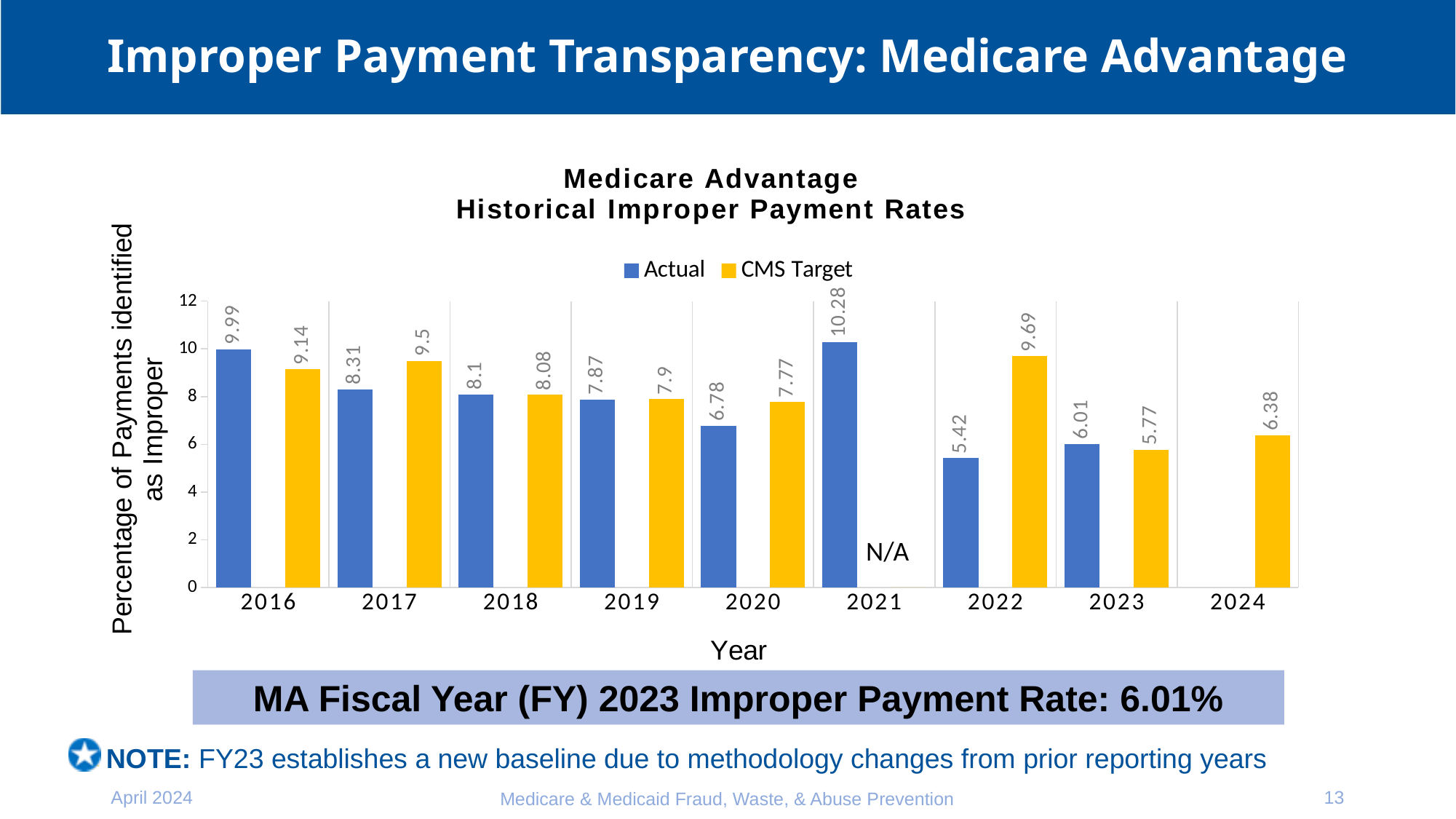
Which is larger for 2017, the Actual value or the CMS Target value? CMS Target What is the CMS Target value for 2022? 9.69 What label is shown in place of the CMS Target bar for 2021? N/A Which year has the highest Actual improper payment rate? 2021 How many series does the legend list? 2 How many years are shown on the x axis? 9 Which year has the lowest Actual improper payment rate? 2022 Is the Actual value for 2021 greater or less than 10? greater What is the difference between the Actual value and the CMS Target value for 2023? 0.24 What is the Actual improper payment rate for 2016? 9.99 What kind of chart is shown on the slide? bar chart What is the CMS Target value for 2024? 6.38